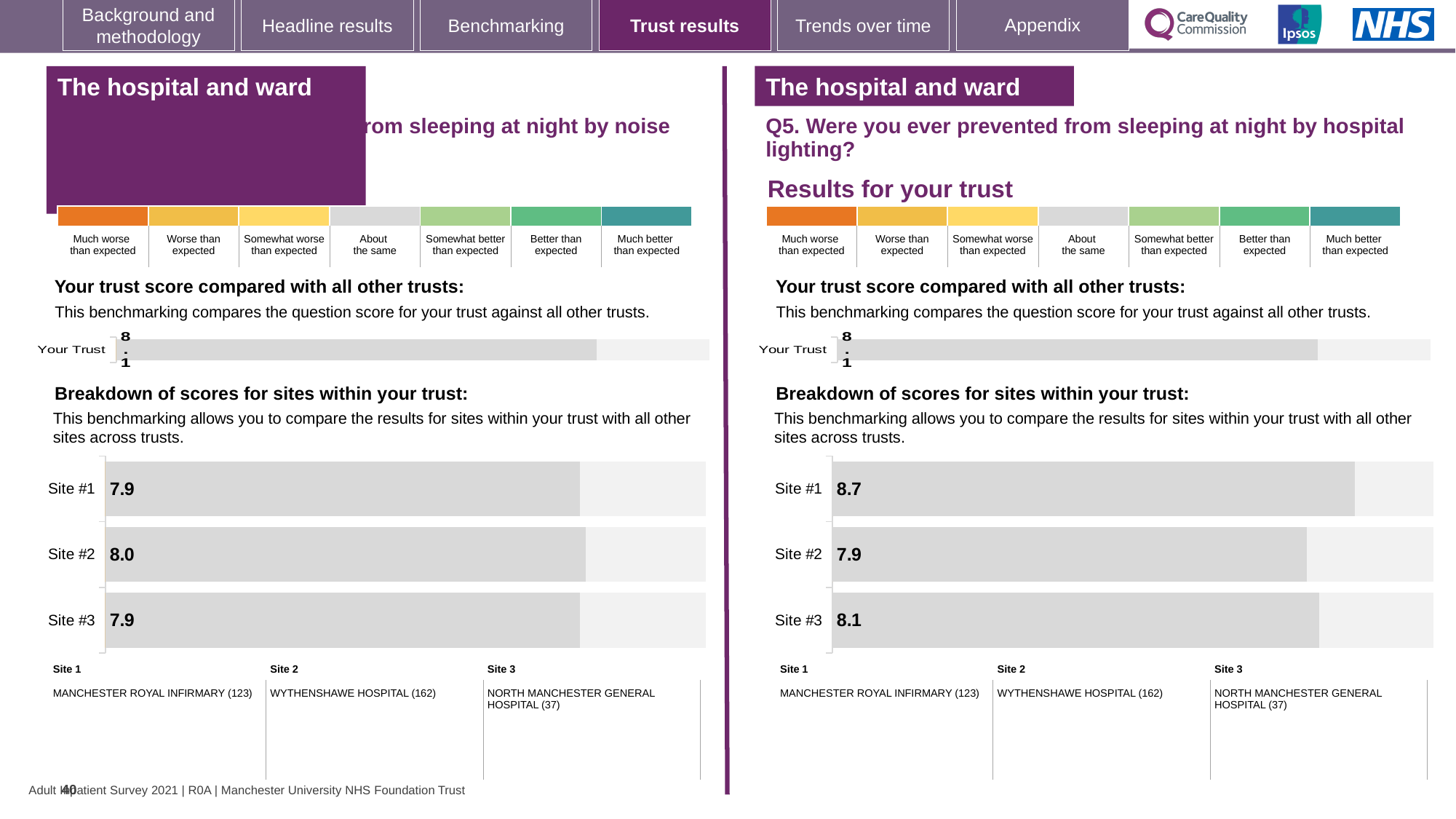
On the right-hand chart (Q5, hospital lighting), what is the score for Site #3? 8.1 On the right-hand chart (Q5, hospital lighting), which is larger: the score for Site #1 or Site #3? Site #1 On the right-hand chart (Q5, hospital lighting), what is the score for Site #1? 8.7 On the left-hand chart (sleeping at night by noise), what is the score for Site #1? 7.9 On the left-hand chart (sleeping at night by noise), which site has the highest score? Site #2 How many sites are shown in the site breakdown chart on the left-hand side of the slide? 3 On the right-hand chart (Q5, hospital lighting), what is the score for Site #2? 7.9 On the left-hand chart (sleeping at night by noise), what is the score for Site #2? 8.0 On the right-hand chart (Q5, hospital lighting), which site has the highest score? Site #1 On the right-hand chart (Q5, hospital lighting), which site has the lowest score? Site #2 On the right-hand chart (Q5, hospital lighting), what is the difference between the Site #1 and Site #2 scores? 0.8 What kind of chart is used for the breakdown of scores for sites on the right-hand side of the slide? Bar chart